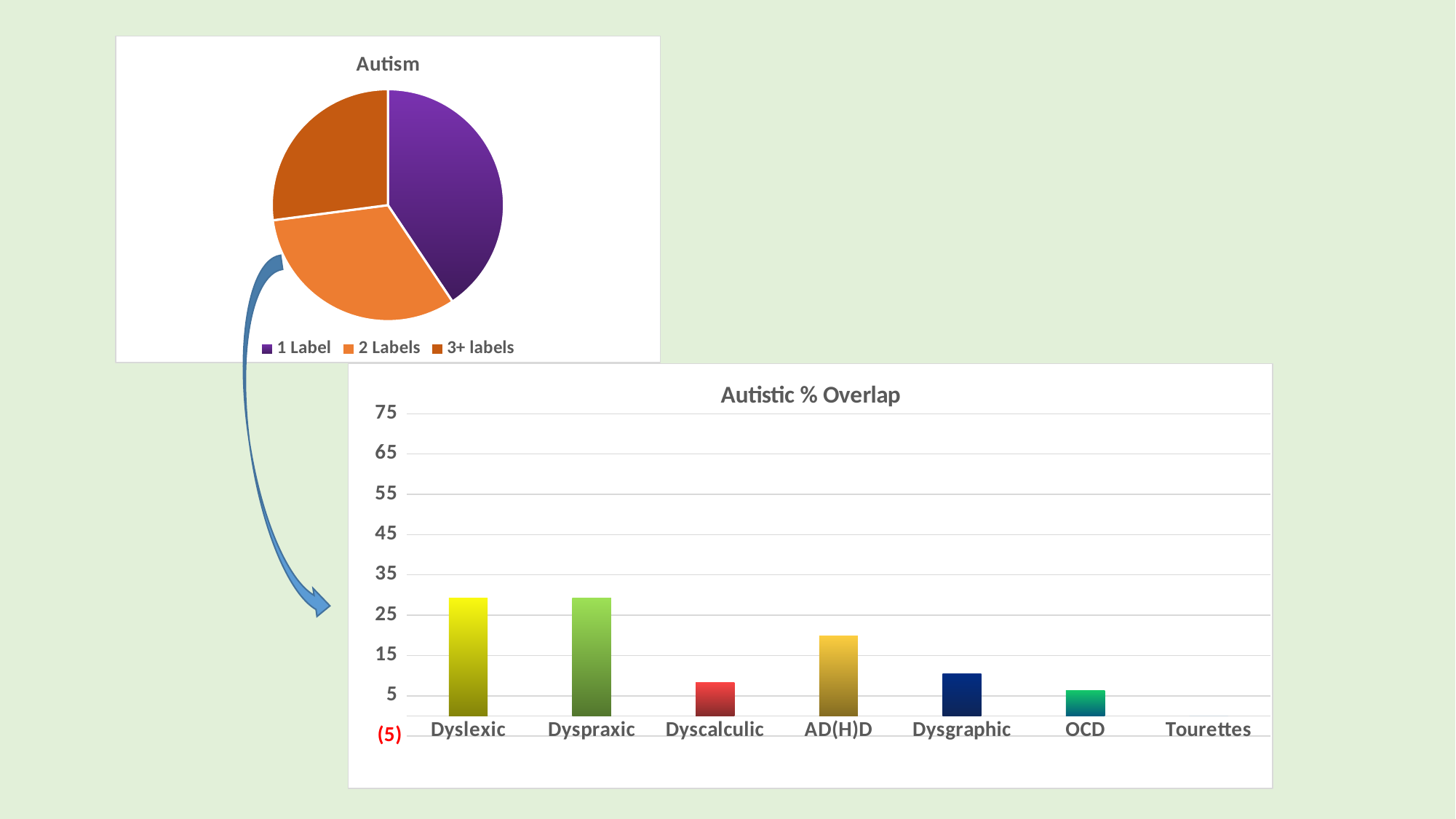
In the 'Autistic % Overlap' chart, which is larger, the value for AD(H)D or the value for Dysgraphic? AD(H)D In the 'Autism' pie chart, how many entries does the legend list? 3 In the 'Autism' pie chart, what colour is the '2 Labels' slice? orange In the 'Autistic % Overlap' chart, is the value for OCD greater or less than 15? less In the 'Autistic % Overlap' chart, is the value for Dysgraphic greater or less than 15? less In the 'Autistic % Overlap' chart, is the value for AD(H)D greater or less than 25? less In the 'Autism' pie chart, which slice is the smallest? 3+ labels What kind of chart is the 'Autism' chart at the top left of the slide? pie chart In the 'Autistic % Overlap' chart, how many categories are shown on the x axis? 7 What kind of chart is the 'Autistic % Overlap' chart? bar chart In the 'Autistic % Overlap' chart, which is larger, the value for Dyslexic or the value for Dyscalculic? Dyslexic